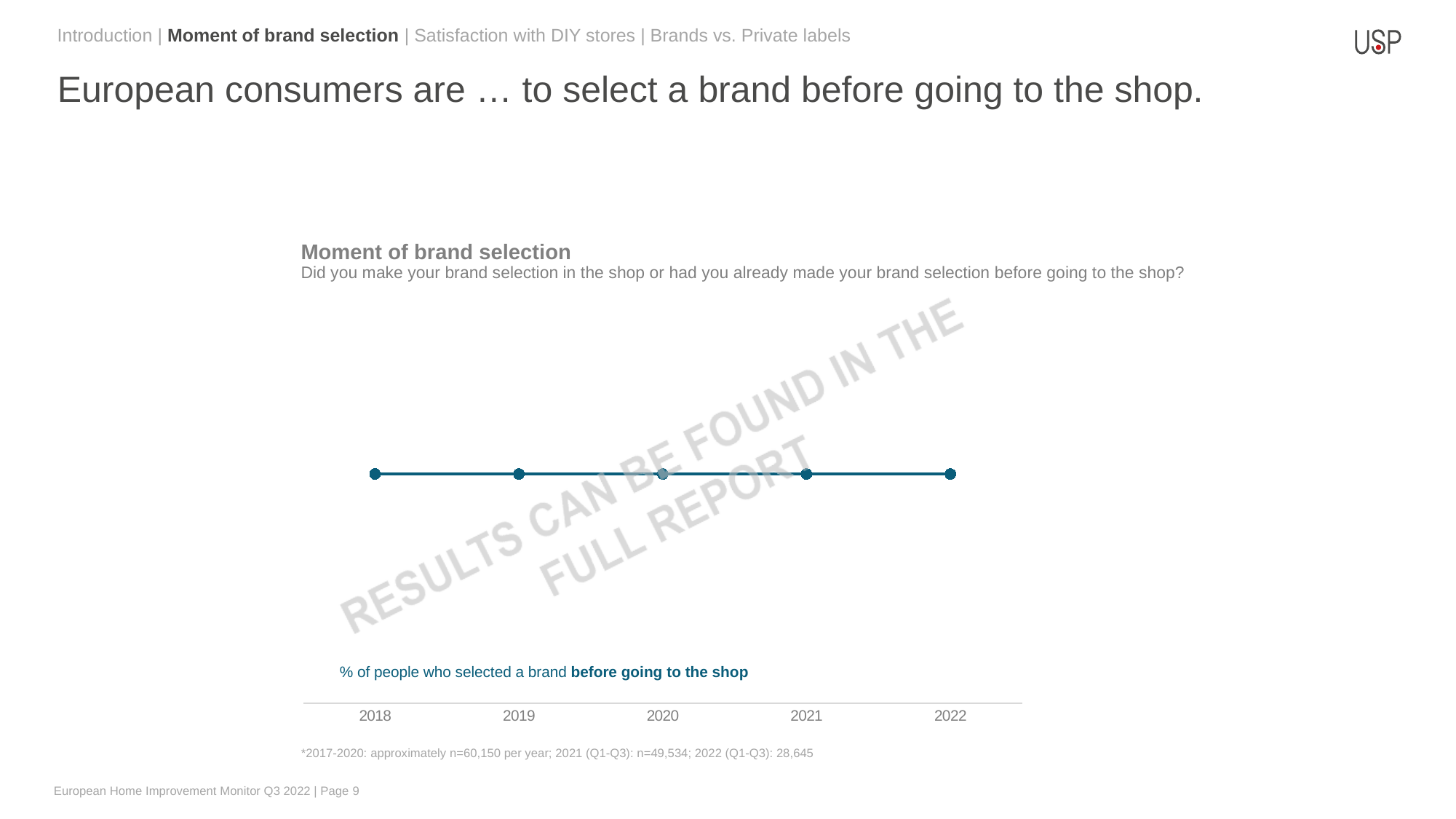
What does the plotted line represent, according to the label below the chart? % of people who selected a brand before going to the shop What kind of chart is shown on the slide? Line chart How many series are plotted on the chart? 1 Which years are shown on the x axis of the chart? 2018, 2019, 2020, 2021, 2022 What is the first year shown on the x axis of the chart? 2018 How many data points are plotted on the line chart? 5 What is the last year shown on the x axis of the chart? 2022 Does the plotted line rise, fall, or stay flat from 2018 to 2022? Stays flat What is the title of the chart? Moment of brand selection